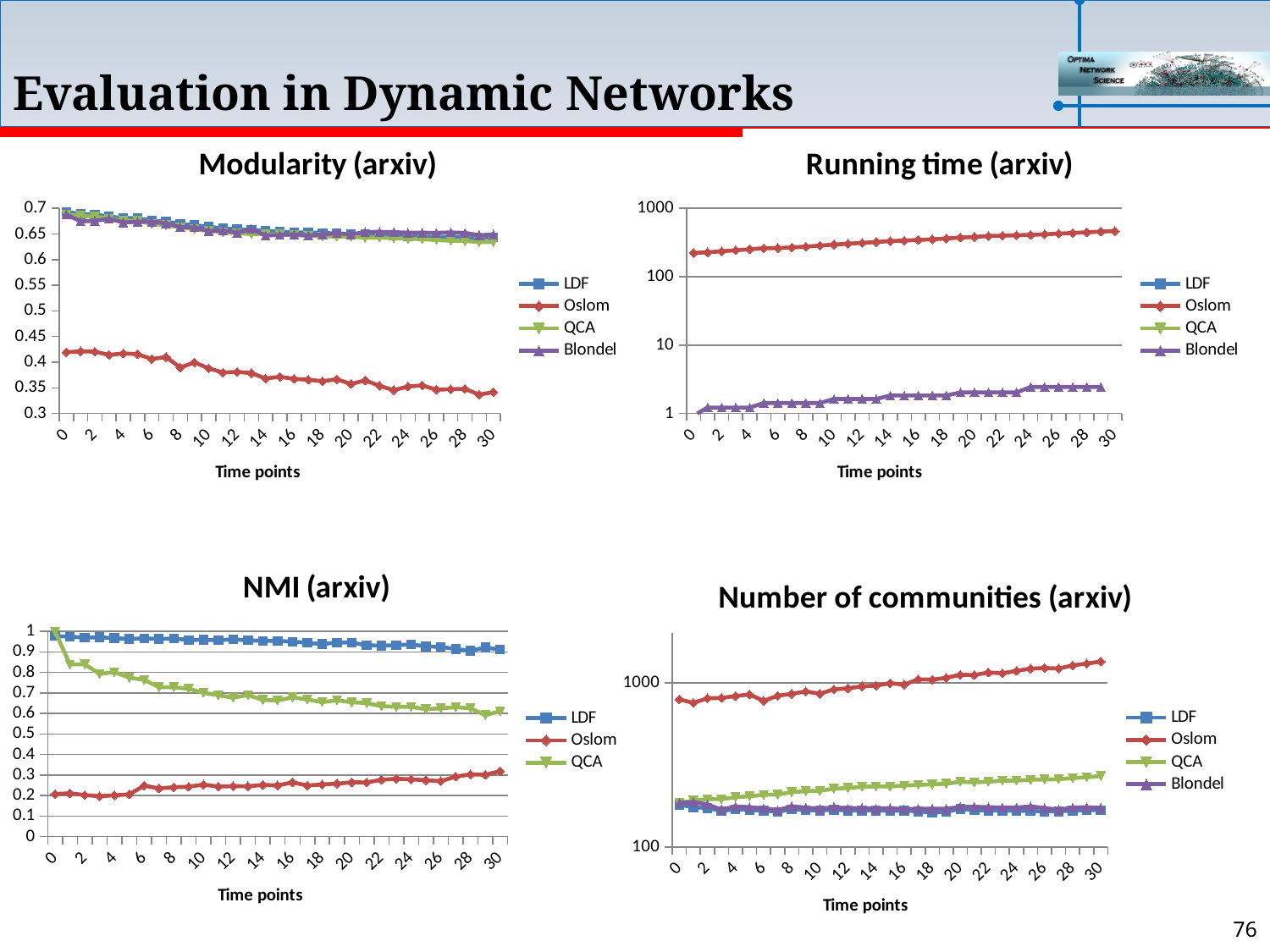
In the Number of communities (arxiv) chart, which series has the highest values? Oslom In the NMI (arxiv) chart, does the QCA series rise or fall as time points increase? fall What kind of chart is the Modularity (arxiv) chart? line chart In the NMI (arxiv) chart, is the Oslom value at time point 0 greater or less than 0.5? less In the Running time (arxiv) chart, is the Blondel value at time point 30 greater or less than 10? less In the Modularity (arxiv) chart, is the Oslom value at time point 0 greater or less than 0.5? less In the Running time (arxiv) chart, does the Oslom series rise or fall as time points increase? rise In the Modularity (arxiv) chart, does the Oslom series rise or fall as time points increase? fall How many series does the legend of the Modularity (arxiv) chart list? 4 How many series does the legend of the NMI (arxiv) chart list? 3